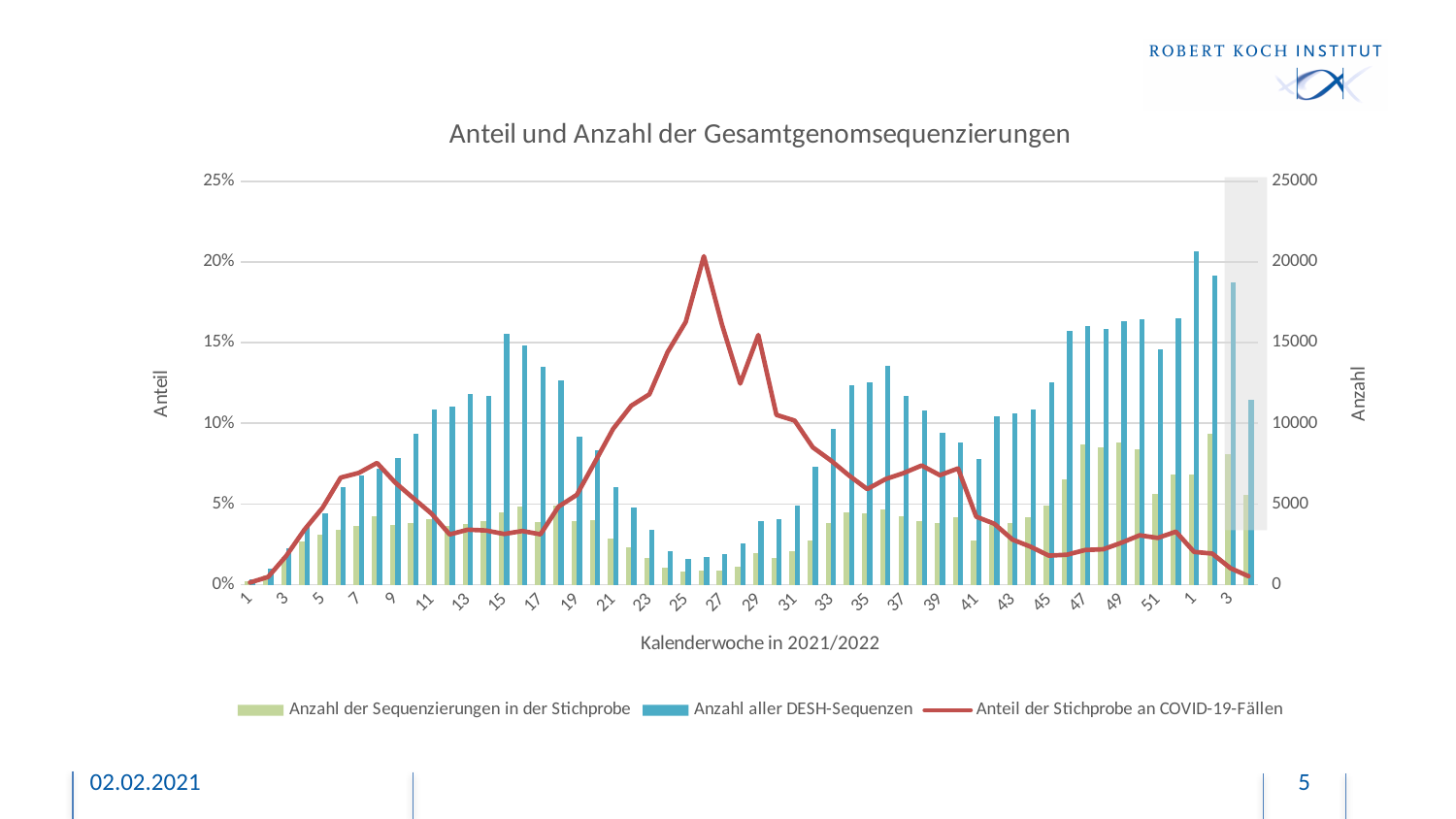
Is the value of 'Anteil der Stichprobe an COVID-19-Fällen' in calendar week 1 of 2021 greater or less than 5%? less Does the line 'Anteil der Stichprobe an COVID-19-Fällen' rise or fall between calendar week 19 and calendar week 26? rise Is the value of 'Anzahl aller DESH-Sequenzen' in calendar week 1 of 2022 greater or less than 15000? greater What is the title of the chart? Anteil und Anzahl der Gesamtgenomsequenzierungen In which calendar week does the line 'Anteil der Stichprobe an COVID-19-Fällen' reach its highest value? Week 26 Which is larger, 'Anzahl aller DESH-Sequenzen' in calendar week 15 or in calendar week 25? Week 15 Is the value of 'Anzahl der Sequenzierungen in der Stichprobe' in calendar week 47 greater or less than 5000? greater What kind of chart is shown on the slide? A bar chart combined with a line chart How many series does the legend list? 3 Which series is drawn as a line rather than as bars? Anteil der Stichprobe an COVID-19-Fällen In which calendar week is the bar for 'Anzahl aller DESH-Sequenzen' the tallest? Week 1 of 2022